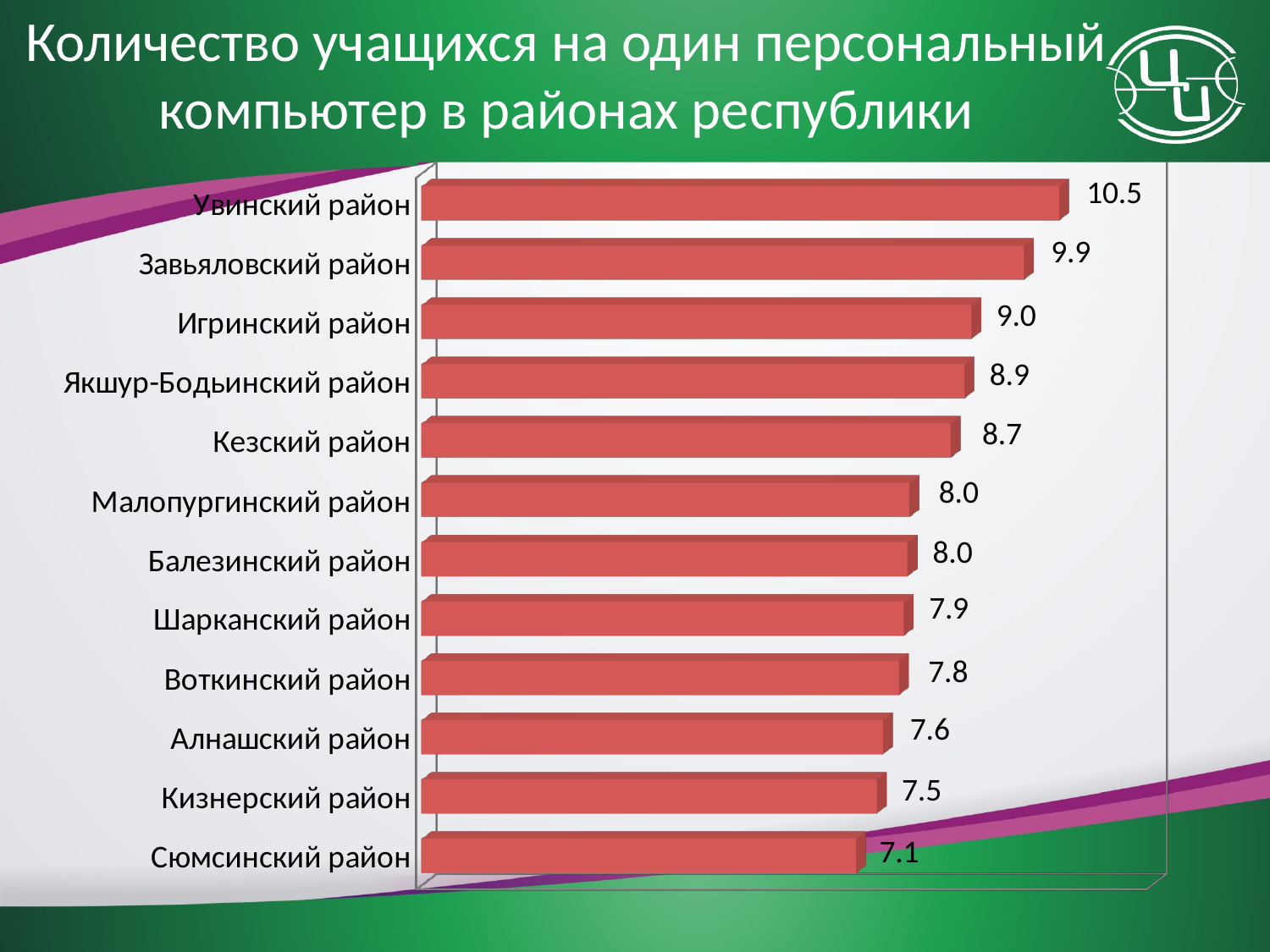
What is the value for Кезский район? 8.7 What is the title of the slide? Количество учащихся на один персональный компьютер в районах республики What is the value for Алнашский район? 7.6 What is the value for Сюмсинский район? 7.1 How many districts are shown in the chart? 12 Which is larger, the value for Якшур-Бодьинский район or the value for Воткинский район? Якшур-Бодьинский район What is the difference between the values for Завьяловский район and Игринский район? 0.9 Which district has the highest value? Увинский район What is the difference between the values for Увинский район and Сюмсинский район? 3.4 What kind of chart is shown on the slide? bar chart Which district has the lowest value? Сюмсинский район What is the value for Увинский район? 10.5